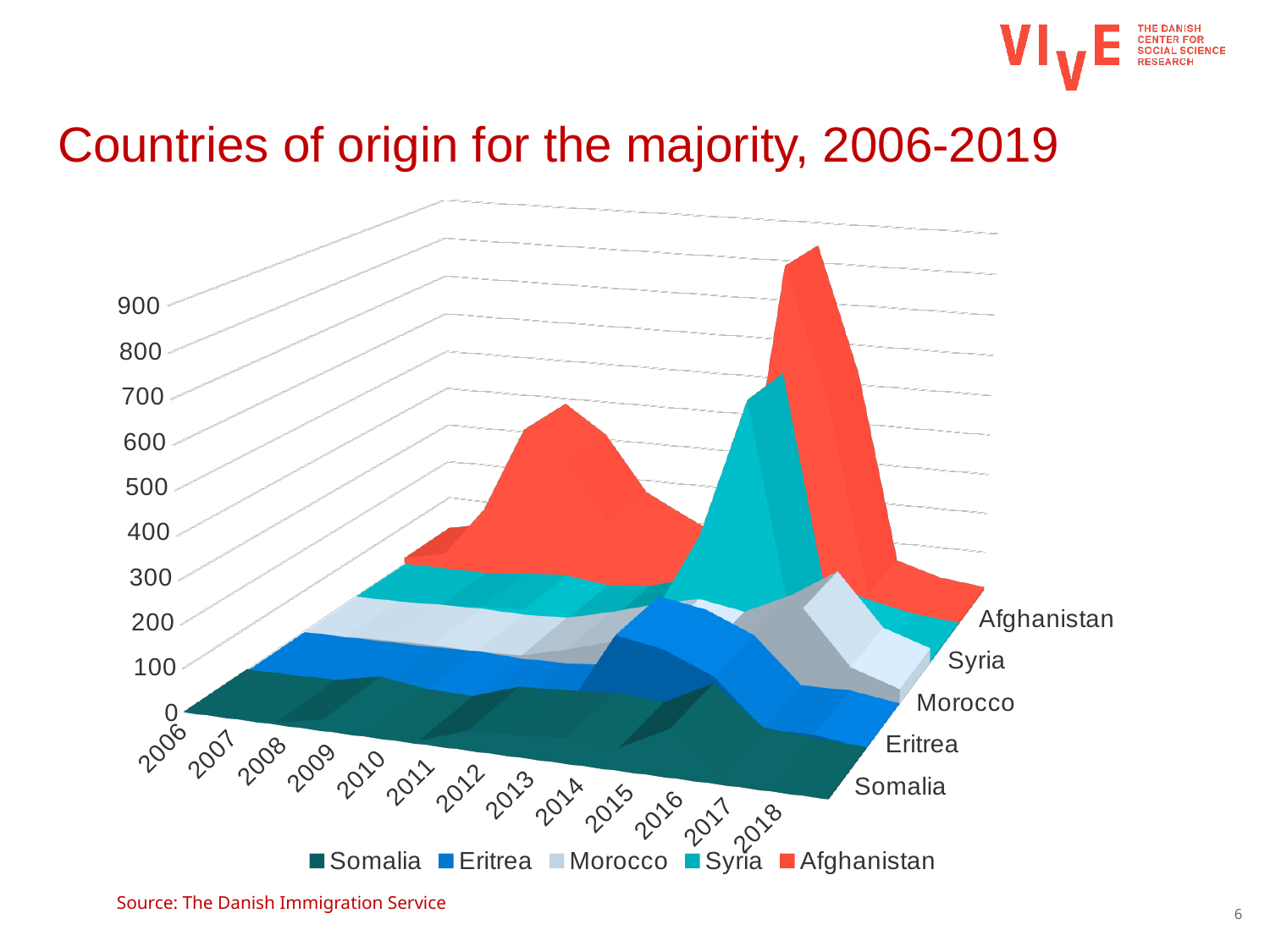
What kind of chart is shown on the slide? Area chart Which series has the larger peak, Syria or Morocco? Syria Which series has the larger peak, Afghanistan or Syria? Afghanistan Which country's series reaches the highest value in the chart? Afghanistan What is the title of the chart on the slide? Countries of origin for the majority, 2006-2019 How many years are labelled along the x axis of the chart? 13 How many series does the legend list? 5 Is the peak value for Afghanistan greater or less than 300? greater What is the first year shown on the x axis? 2006 Is the peak value for Syria greater or less than 200? greater Is the highest value for Somalia greater or less than 300? less Which country is shown in red in the chart legend? Afghanistan